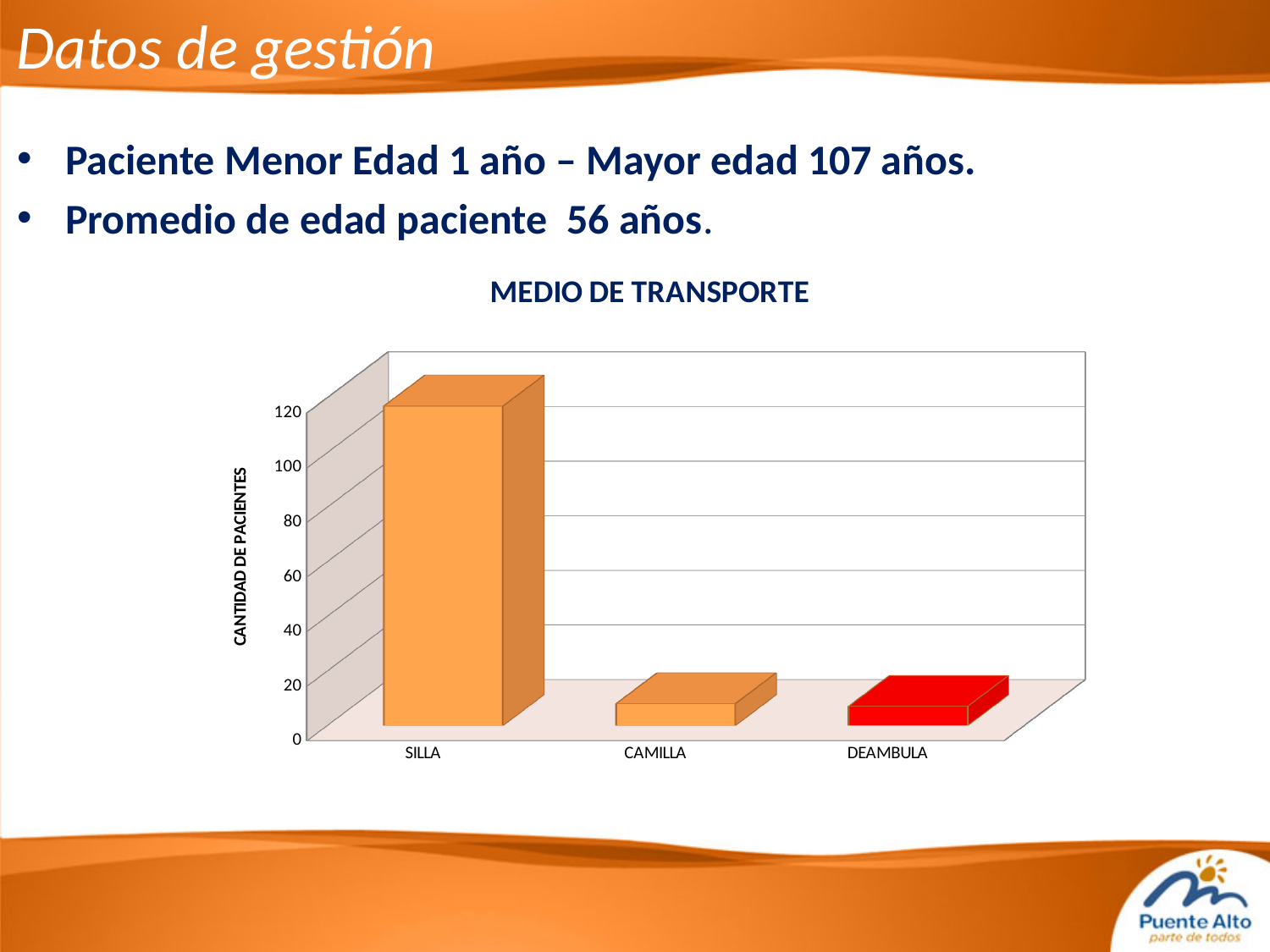
What type of chart is shown on the slide? bar chart Is the value for CAMILLA greater or less than 20? less Which is larger, the value for SILLA or the value for CAMILLA? SILLA How many categories are shown on the x axis of the chart? 3 Is the value for SILLA greater or less than 100? greater What is the label of the vertical axis of the chart? CANTIDAD DE PACIENTES Is the value for DEAMBULA greater or less than 40? less Which category has the highest value in the chart? SILLA What is the title of the chart? MEDIO DE TRANSPORTE Which is larger, the value for SILLA or the value for DEAMBULA? SILLA